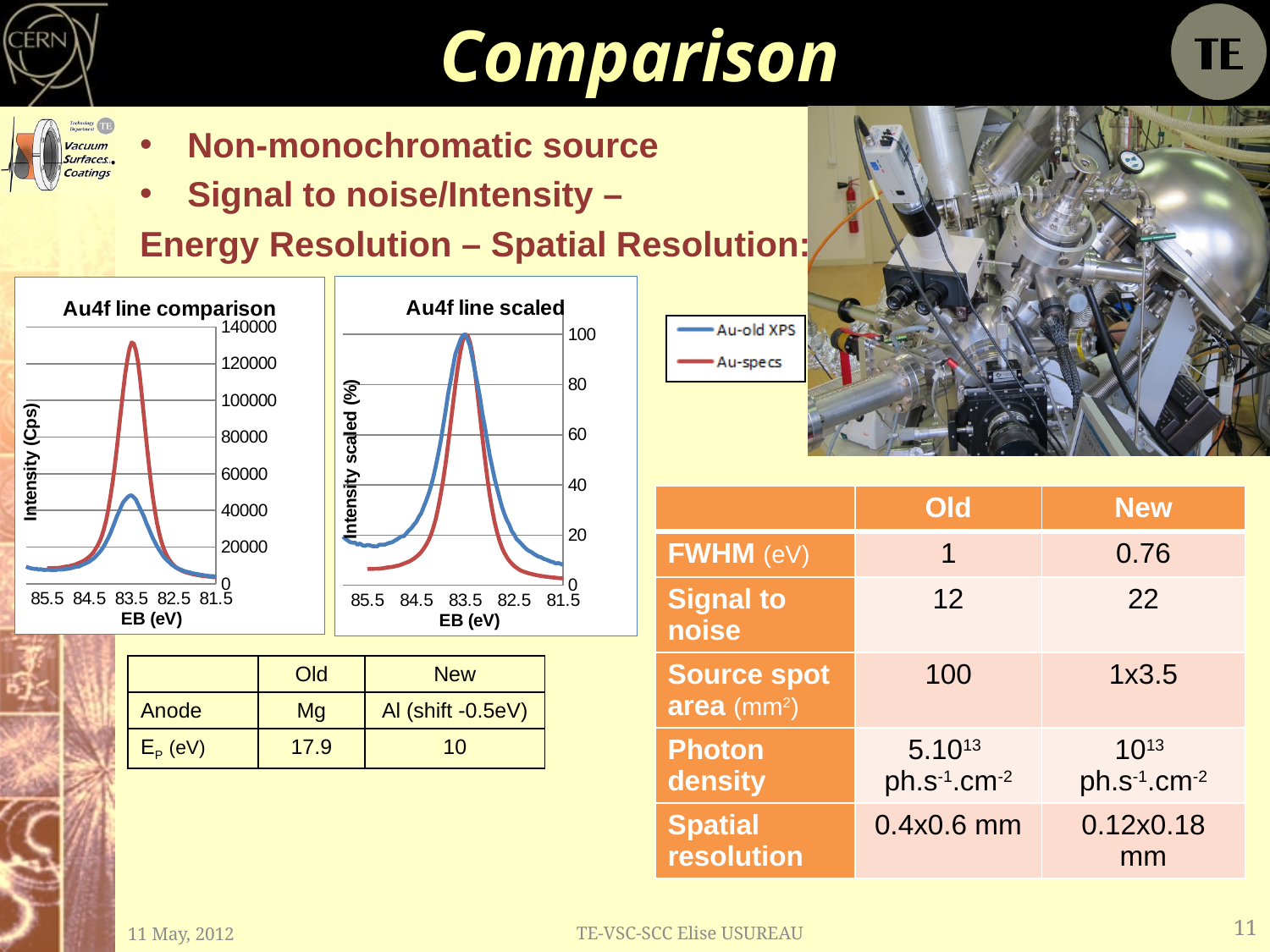
How many series does the legend list for the Au4f charts? 2 In the "Au4f line comparison" chart, is the peak value of the Au-old XPS series greater or less than 40000? greater In the "Au4f line scaled" chart, which series has the wider peak? Au-old XPS What is the maximum value shown on the y-axis of the "Au4f line scaled" chart? 100 In the "Au4f line comparison" chart, is the peak value of the Au-old XPS series greater or less than 60000? less What kind of chart is the "Au4f line comparison" chart? line chart What is the y-axis title of the "Au4f line comparison" chart? Intensity (Cps) How many line charts are shown on the slide? 2 In the "Au4f line scaled" chart, at which EB (eV) tick do both series reach their peak? 83.5 What are the two series named in the legend of the Au4f charts? Au-old XPS and Au-specs In the "Au4f line comparison" chart, which series reaches the higher peak intensity? Au-specs In the "Au4f line comparison" chart, is the peak value of the Au-specs series greater or less than 120000? greater